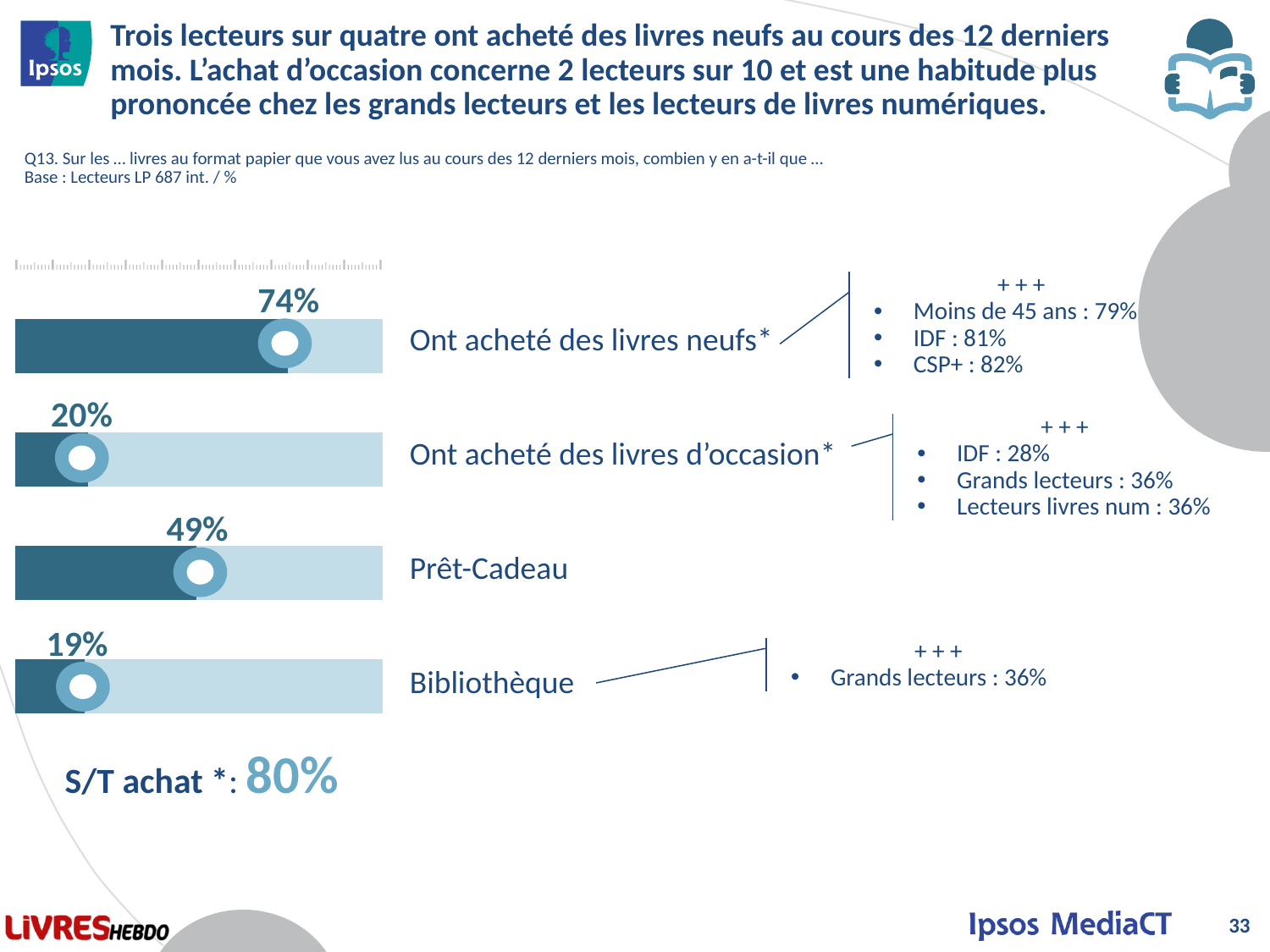
Which category has the lowest value? Bibliothèque Which category has the highest value? Ont acheté des livres neufs* What is the difference between the values for "Ont acheté des livres neufs*" and "Prêt-Cadeau"? 25% Which is larger, the value for "Prêt-Cadeau" or the value for "Ont acheté des livres d'occasion*"? Prêt-Cadeau What is the value shown for "S/T achat *" below the chart? 80% What is the value for "Bibliothèque"? 19% What is the value for "Prêt-Cadeau"? 49% How many categories are shown in the chart? 4 What kind of chart is shown on the slide? Bar chart What is the value for "Ont acheté des livres neufs*"? 74% What is the difference between the values for "Ont acheté des livres d'occasion*" and "Bibliothèque"? 1% What is the value for "Ont acheté des livres d'occasion*"? 20%